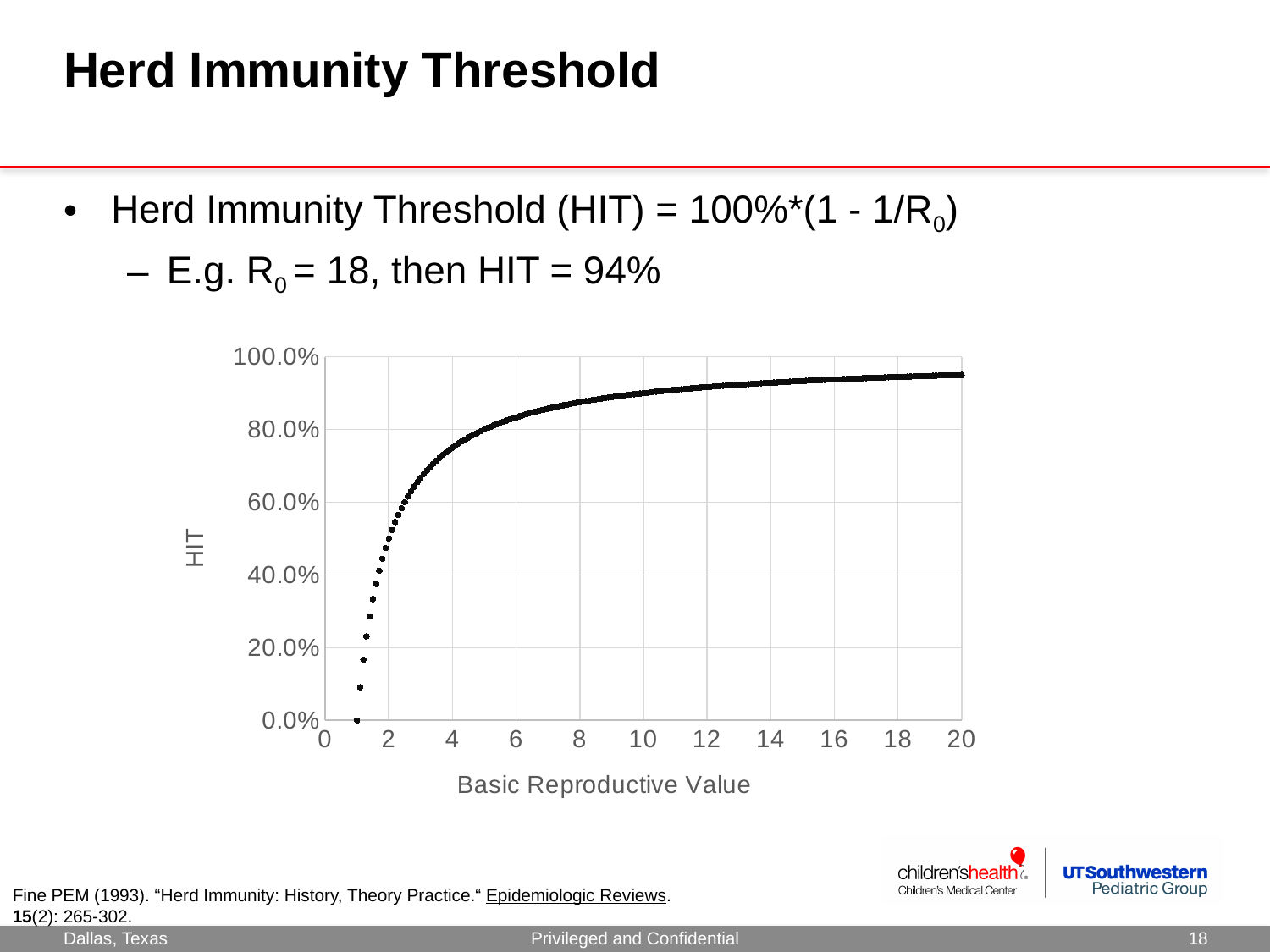
What is the title of the y axis of the chart? HIT Is the HIT value at a Basic Reproductive Value of 6 greater or less than 80.0%? greater Is the HIT value at a Basic Reproductive Value of 4 greater or less than 60.0%? greater Is the HIT value at a Basic Reproductive Value of 10 greater or less than 80.0%? greater What is the highest value shown on the y axis of the chart? 100.0% Which has the higher HIT value: a Basic Reproductive Value of 2 or a Basic Reproductive Value of 10? 10 What is the title of the x axis of the chart? Basic Reproductive Value What kind of chart is shown on the slide? scatter chart Do the HIT values rise or fall as the Basic Reproductive Value increases along the x axis? rise